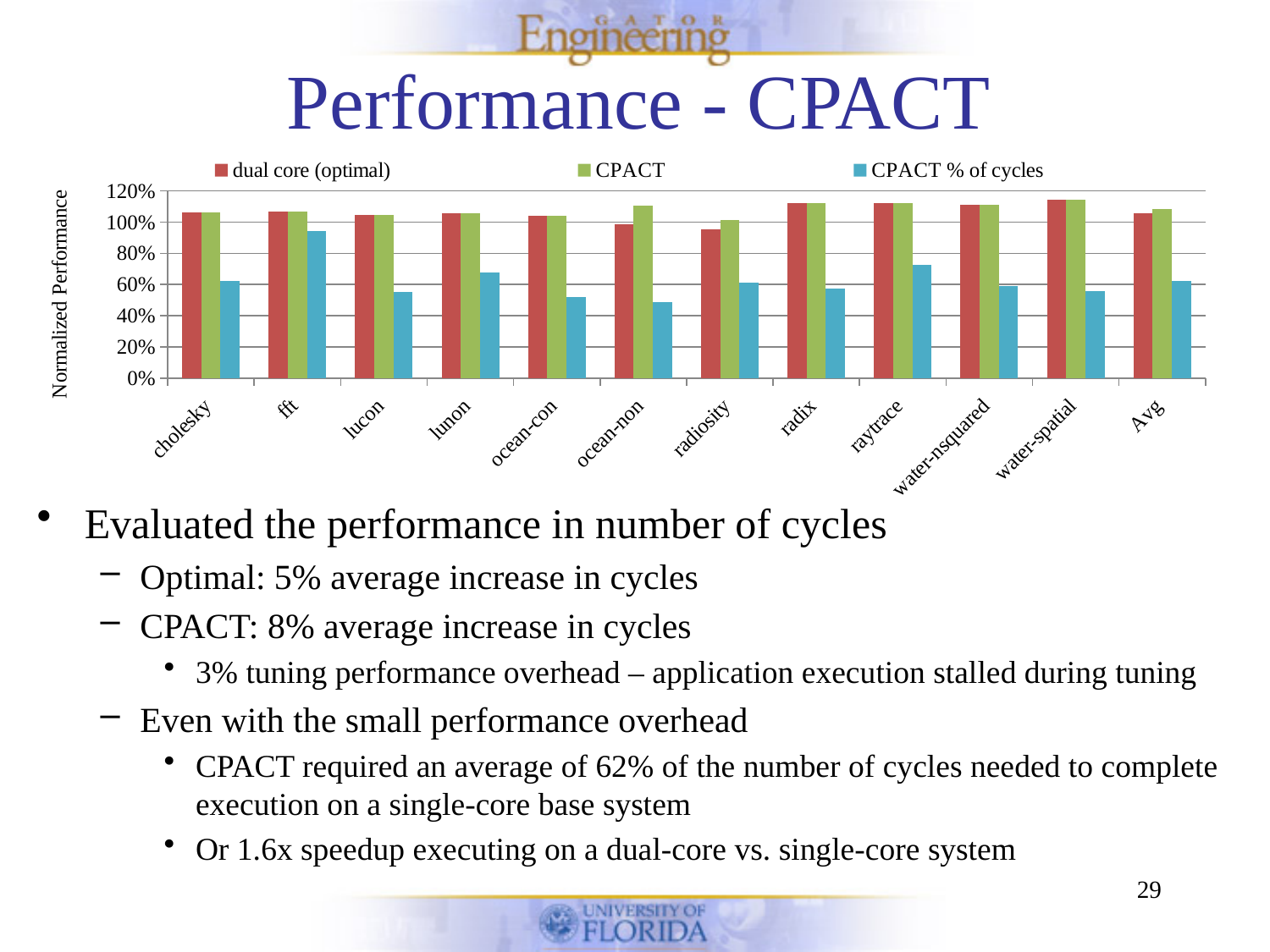
What kind of chart is shown on the slide? bar chart Is the CPACT % of cycles value for raytrace greater or less than 60%? greater What is the title of the vertical axis of the chart? Normalized Performance Which category has the highest value for the CPACT % of cycles series? fft For ocean-non, which is larger: the dual core (optimal) value or the CPACT value? CPACT How many series does the chart legend list? 3 How many categories are shown along the x axis of the chart? 12 Is the CPACT % of cycles value for fft greater or less than 80%? greater Which has the larger CPACT % of cycles value: cholesky or fft? fft Which series is shown in blue in the chart legend? CPACT % of cycles Is the CPACT % of cycles value for ocean-non greater or less than 60%? less